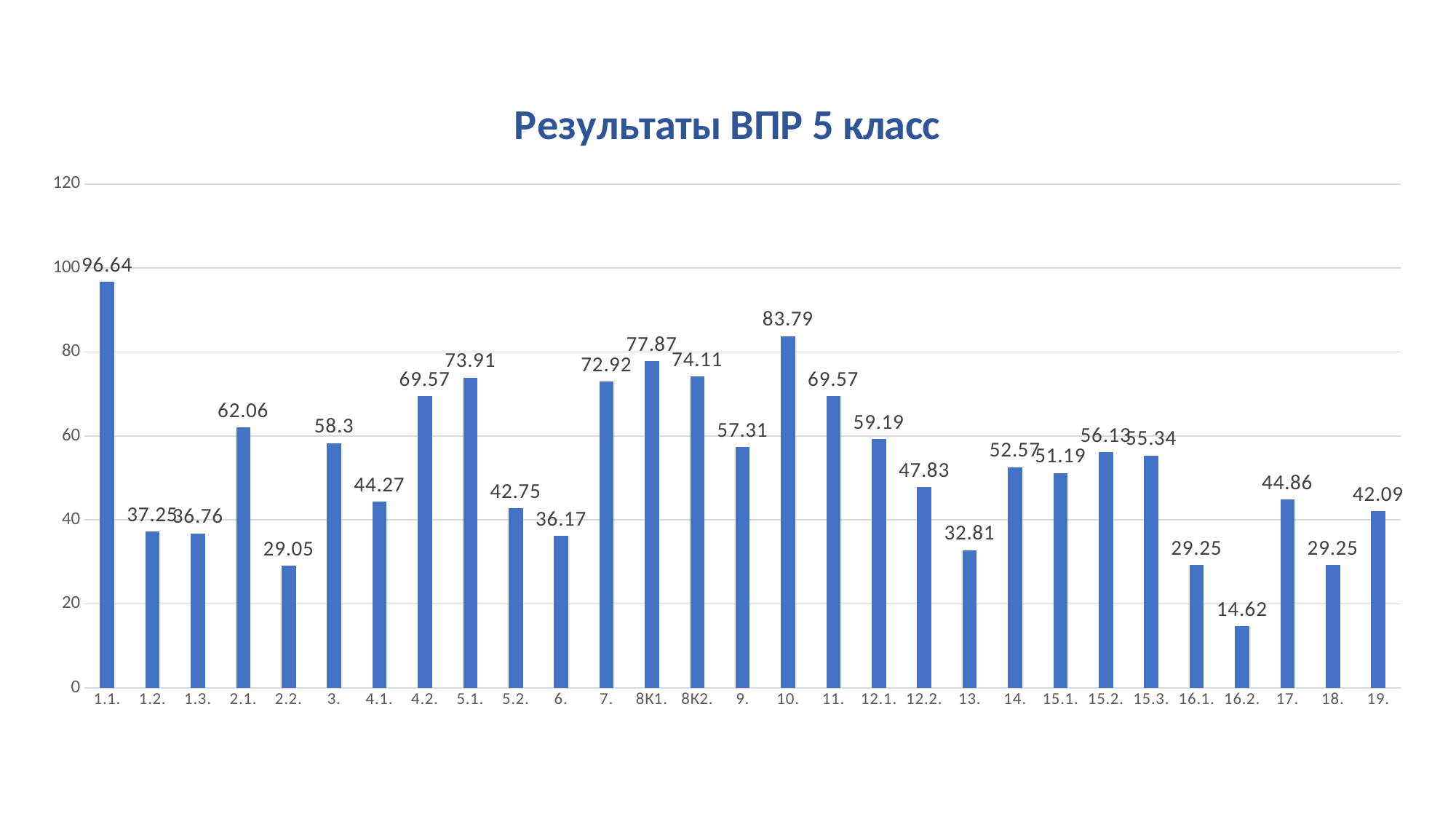
What is the value for category 16.2.? 14.62 What kind of chart is shown on the slide? bar chart What is the difference between the values for 10. and 11.? 14.22 What is the value for category 10.? 83.79 How many categories are shown on the x axis? 29 What is the difference between the values for 1.1. and 16.2.? 82.02 Which category has the highest value? 1.1. Is the value for 13. greater or less than 40? less Which category has the lowest value? 16.2. What is the title of the chart? Результаты ВПР 5 класс What is the value for category 8К1.? 77.87 Which has a larger value, 2.1. or 3.? 2.1.